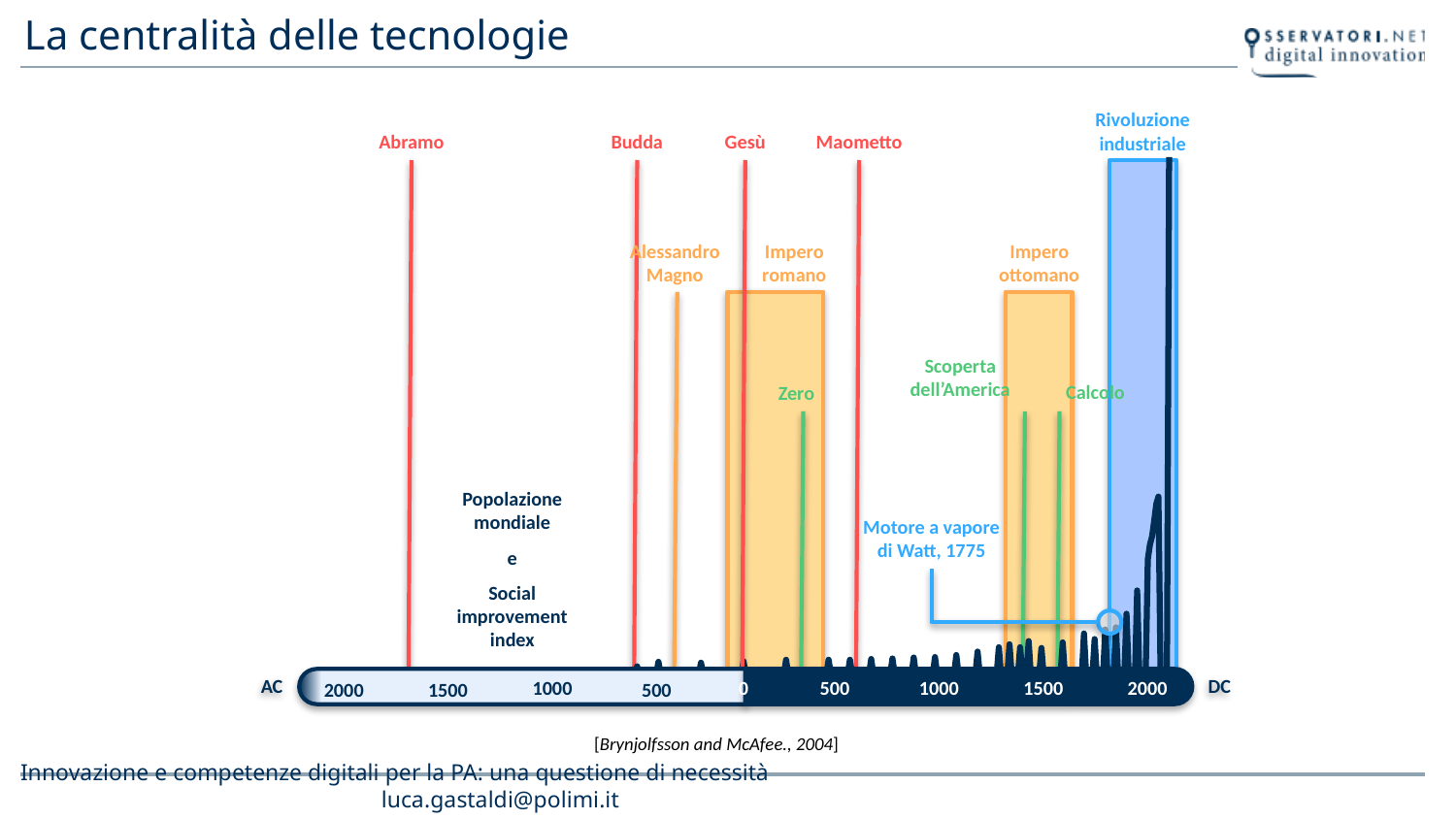
Does the plotted curve rise or fall as it approaches the right end of the timeline (2000 DC)? rise Which labelled period is placed latest (furthest right) on the timeline? Rivoluzione industriale What year is given for the Motore a vapore di Watt on the chart? 1775 Is the Scoperta dell'America line placed before or after the 1500 DC tick on the axis? before How many red vertical lines marking religious figures (Abramo, Budda, Gesù, Maometto) are on the chart? 4 What source is cited below the chart? Brynjolfsson and McAfee., 2004 Which labelled event is placed earliest (furthest left) on the timeline? Abramo What is the leftmost year tick on the AC side of the timeline axis? 2000 What are the two quantities the plotted curve represents, according to the label on the chart? Popolazione mondiale e Social improvement index Which orange-shaded empire is shown between the Gesù and Maometto lines? Impero romano How many events are labelled in green on the chart? 3